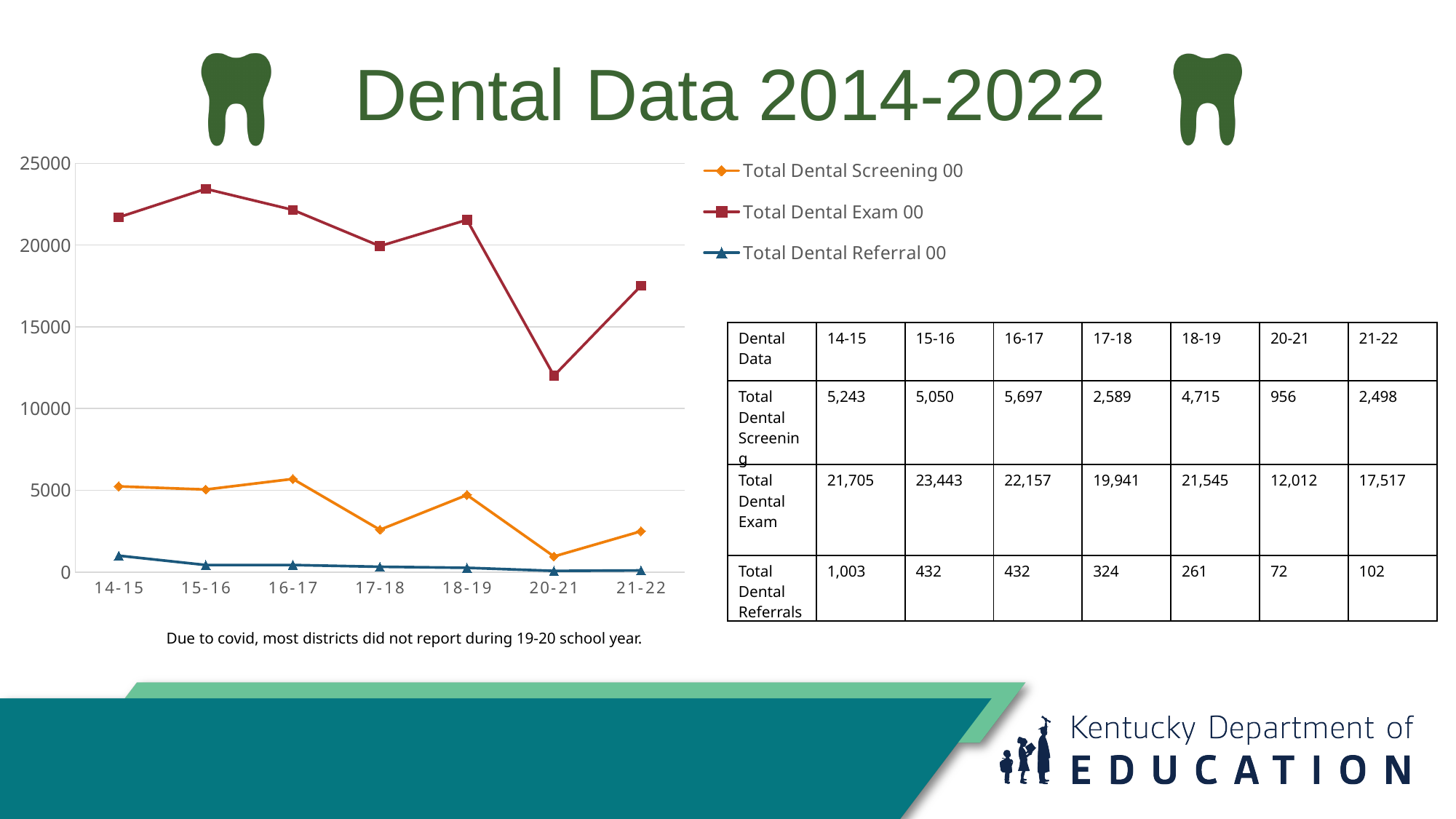
What is the Total Dental Referrals value for 14-15? 1,003 How many series does the chart legend list? 3 What is the difference between the Total Dental Exam values for 18-19 and 20-21? 9,533 What is the Total Dental Exam value for 15-16? 23,443 How many school years are plotted along the x axis of the chart? 7 What kind of chart is shown on the slide? line chart Which series is drawn in orange on the chart? Total Dental Screening 00 In which school year is the Total Dental Exam value highest? 15-16 Is the Total Dental Exam value for 20-21 greater or less than 15000? less In which school year is the Total Dental Screening value lowest? 20-21 Which is larger, the Total Dental Screening value for 16-17 or for 17-18? 16-17 What is the Total Dental Screening value for 20-21? 956